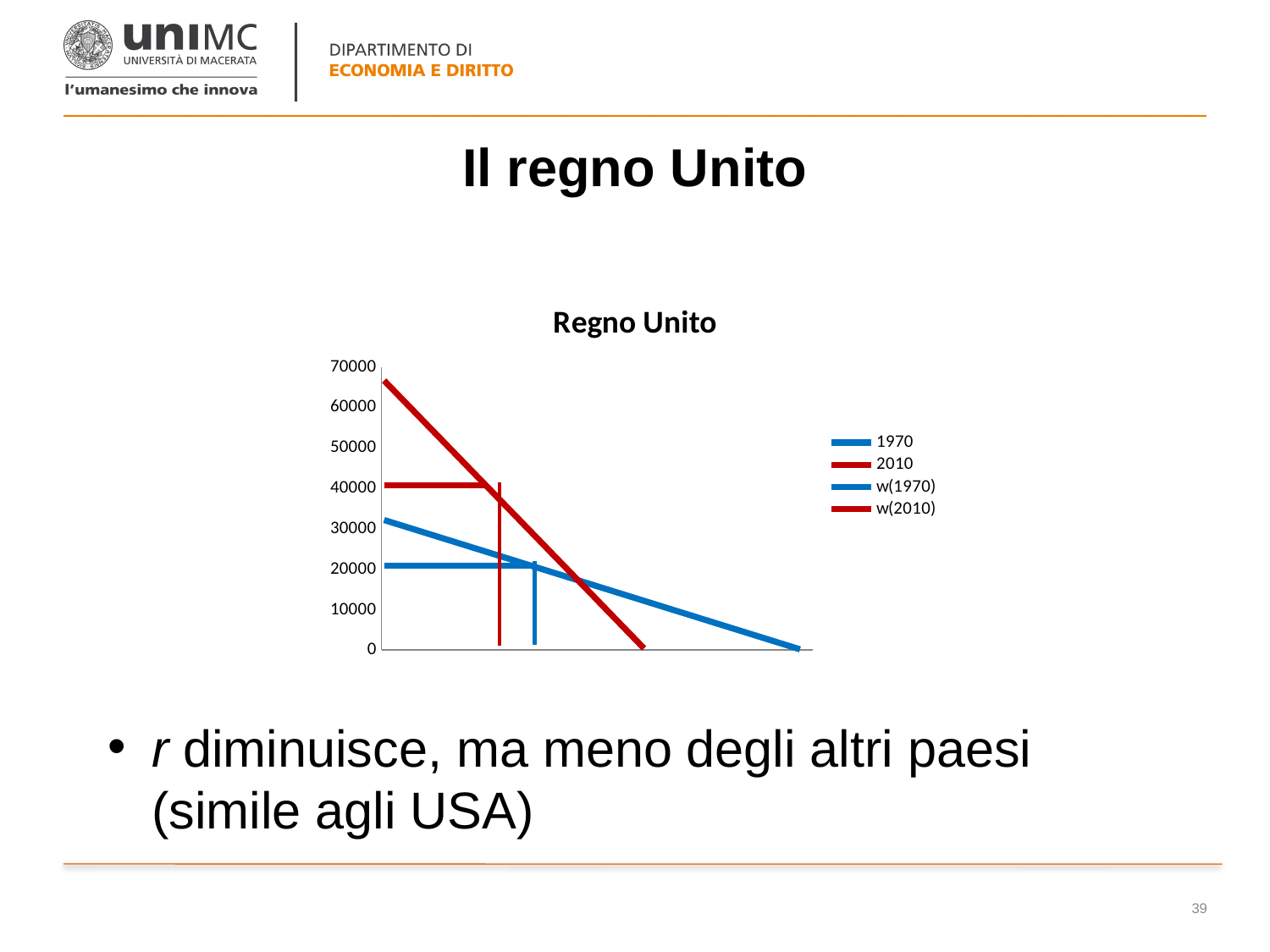
What kind of chart is shown on the slide? line chart Does the 1970 line rise or fall from left to right? fall What colour is the 2010 line in the chart? red Which line starts higher at the left edge of the chart, 1970 or 2010? 2010 Is the level of the horizontal w(1970) line greater or less than 30000? less Is the level of the horizontal w(2010) line greater or less than 30000? greater Which horizontal line is higher, w(1970) or w(2010)? w(2010) What is the title of the chart? Regno Unito How many series does the chart legend list? 4 Is the starting value of the 2010 line at the left edge greater or less than 60000? greater Does the 2010 line rise or fall from left to right? fall